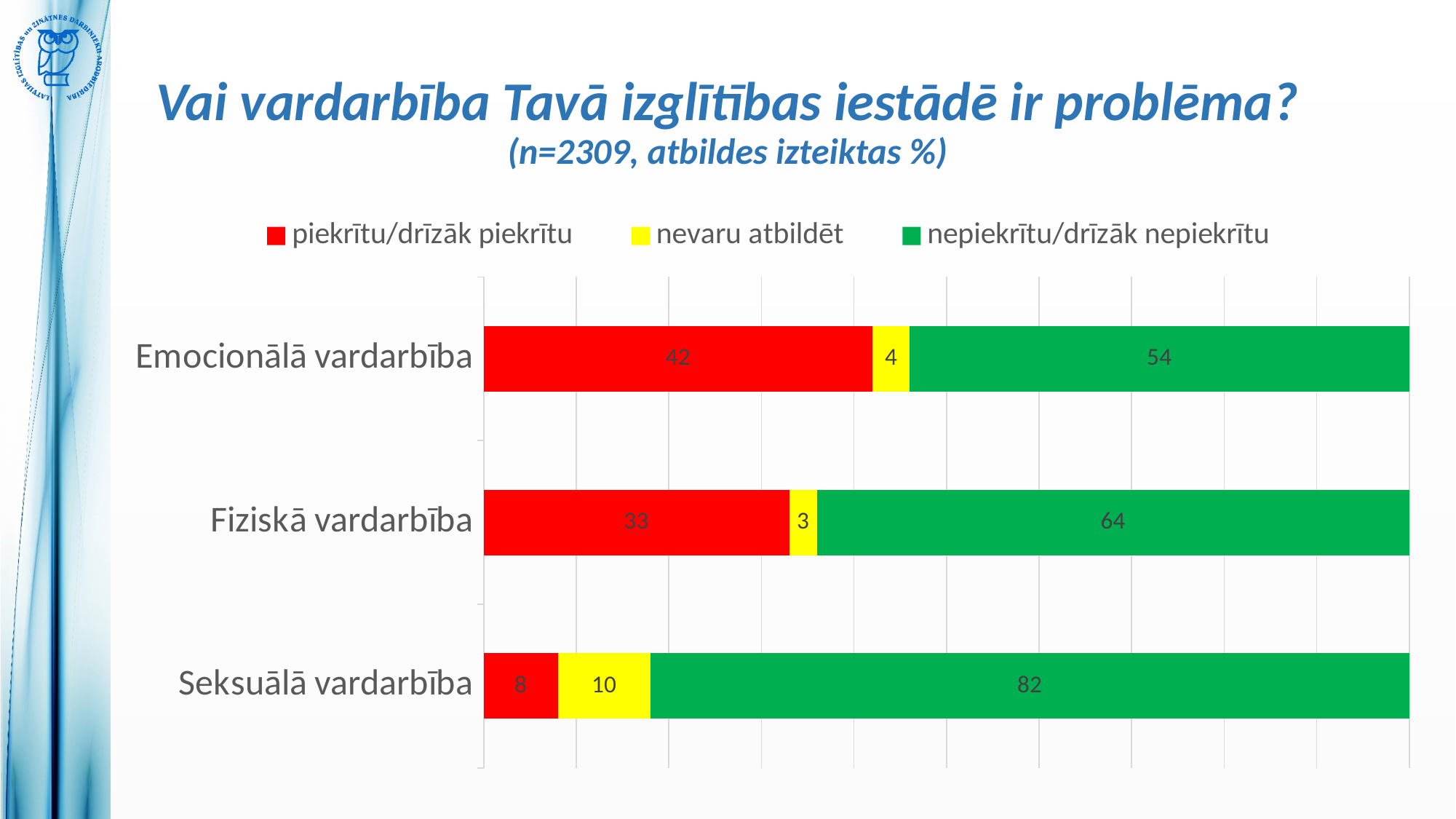
Which colour represents 'nevaru atbildēt' in the legend? Yellow What is the difference between the 'piekrītu/drīzāk piekrītu' values for Emocionālā vardarbība and Fiziskā vardarbība? 9 What is the value for 'piekrītu/drīzāk piekrītu' for Emocionālā vardarbība? 42 How many categories are shown on the chart? 3 Which category has the lowest value for 'piekrītu/drīzāk piekrītu'? Seksuālā vardarbība What is the value for 'nepiekrītu/drīzāk nepiekrītu' for Fiziskā vardarbība? 64 Which is larger: the 'nevaru atbildēt' value for Seksuālā vardarbība or for Emocionālā vardarbība? Seksuālā vardarbība What is the total of the stacked bar for Fiziskā vardarbība? 100 How many series does the legend list? 3 What is the value for 'nevaru atbildēt' for Seksuālā vardarbība? 10 What kind of chart is shown on the slide? Stacked bar chart Which category has the highest value for 'nepiekrītu/drīzāk nepiekrītu'? Seksuālā vardarbība